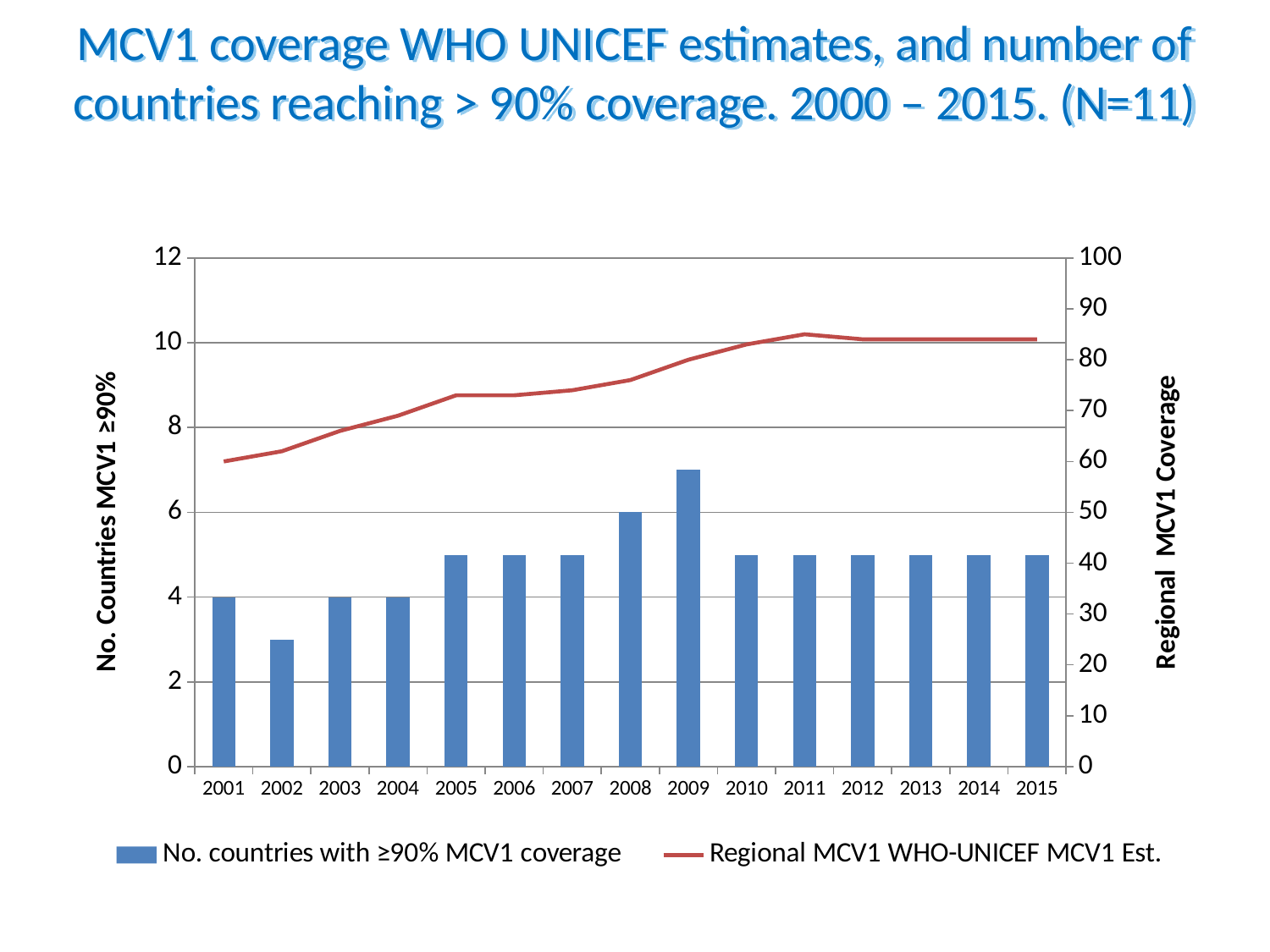
In which year is the number of countries with ≥90% MCV1 coverage lowest? 2002 What kind of chart is shown on the slide? Combined bar and line chart Is the Regional MCV1 WHO-UNICEF estimate for 2001 greater or less than 70? less Does the Regional MCV1 WHO-UNICEF estimate line generally rise or fall from 2001 to 2011? rise How many years are shown on the x axis? 15 Is the Regional MCV1 WHO-UNICEF estimate for 2011 greater or less than 80? greater In which year is the number of countries with ≥90% MCV1 coverage highest? 2009 How many series does the legend list? 2 What is the number of countries with ≥90% MCV1 coverage in 2008? 6